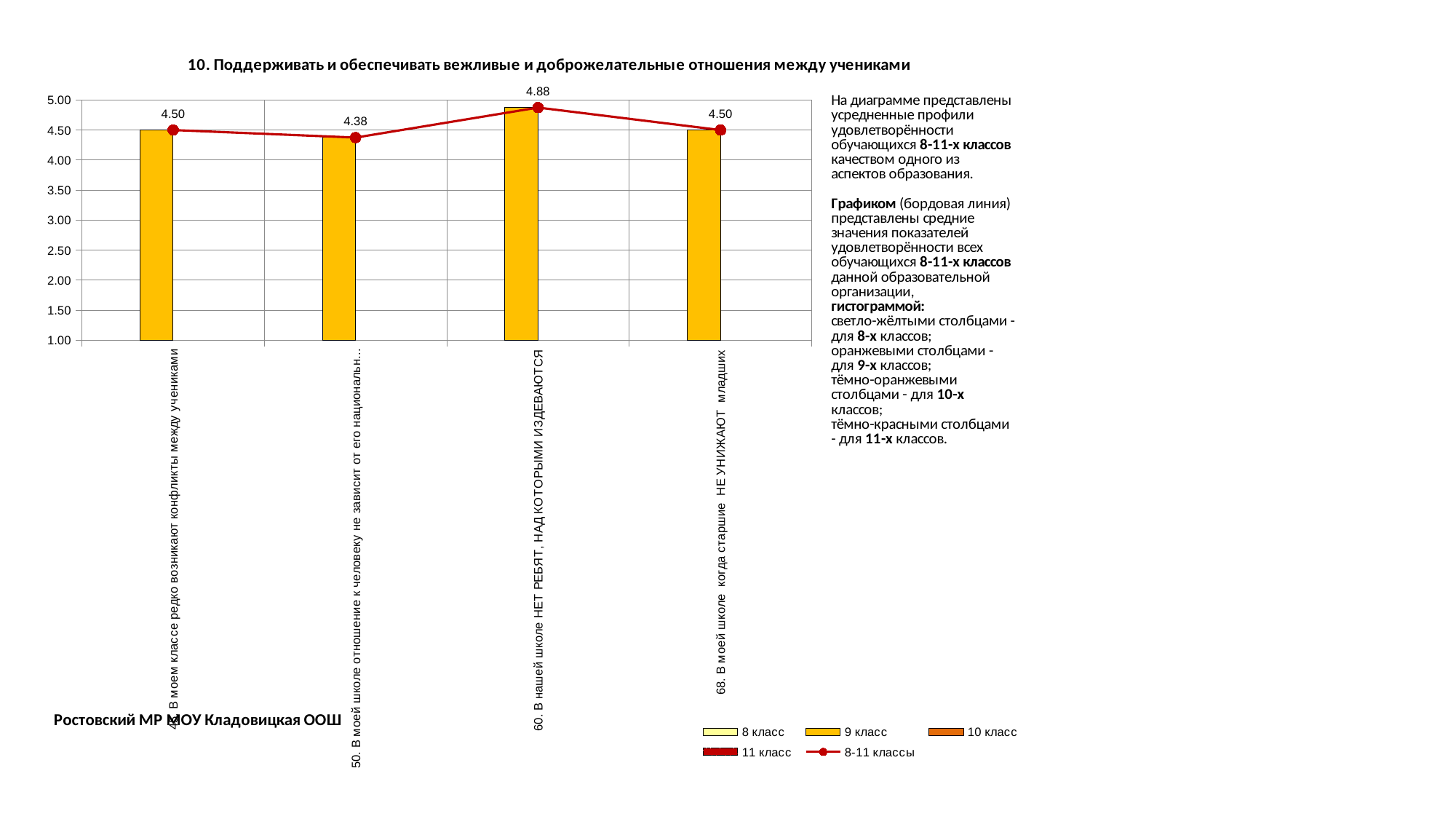
Which category has the lowest value? 50. В моей школе отношение к человеку не зависит от его национальн... How many series does the legend list? 5 Is the value for category 50 greater or less than 4.50? less What value is labelled for the category "60. В нашей школе НЕТ РЕБЯТ, НАД КОТОРЫМИ ИЗДЕВАЮТСЯ"? 4.88 What is the title of the chart? 10. Поддерживать и обеспечивать вежливые и доброжелательные отношения между учениками How many categories are shown on the x axis? 4 Which has the larger value, category 60 or category 50? 60. В нашей школе НЕТ РЕБЯТ, НАД КОТОРЫМИ ИЗДЕВАЮТСЯ Which category has the highest value? 60. В нашей школе НЕТ РЕБЯТ, НАД КОТОРЫМИ ИЗДЕВАЮТСЯ What is the difference between the values for category 60 and category 50? 0.50 What value is labelled for the category "50. В моей школе отношение к человеку не зависит от его национальн..."? 4.38 What value is labelled for the category "68. В моей школе когда старшие НЕ УНИЖАЮТ младших"? 4.50 What is the difference between the values for category 68 and category 50? 0.12